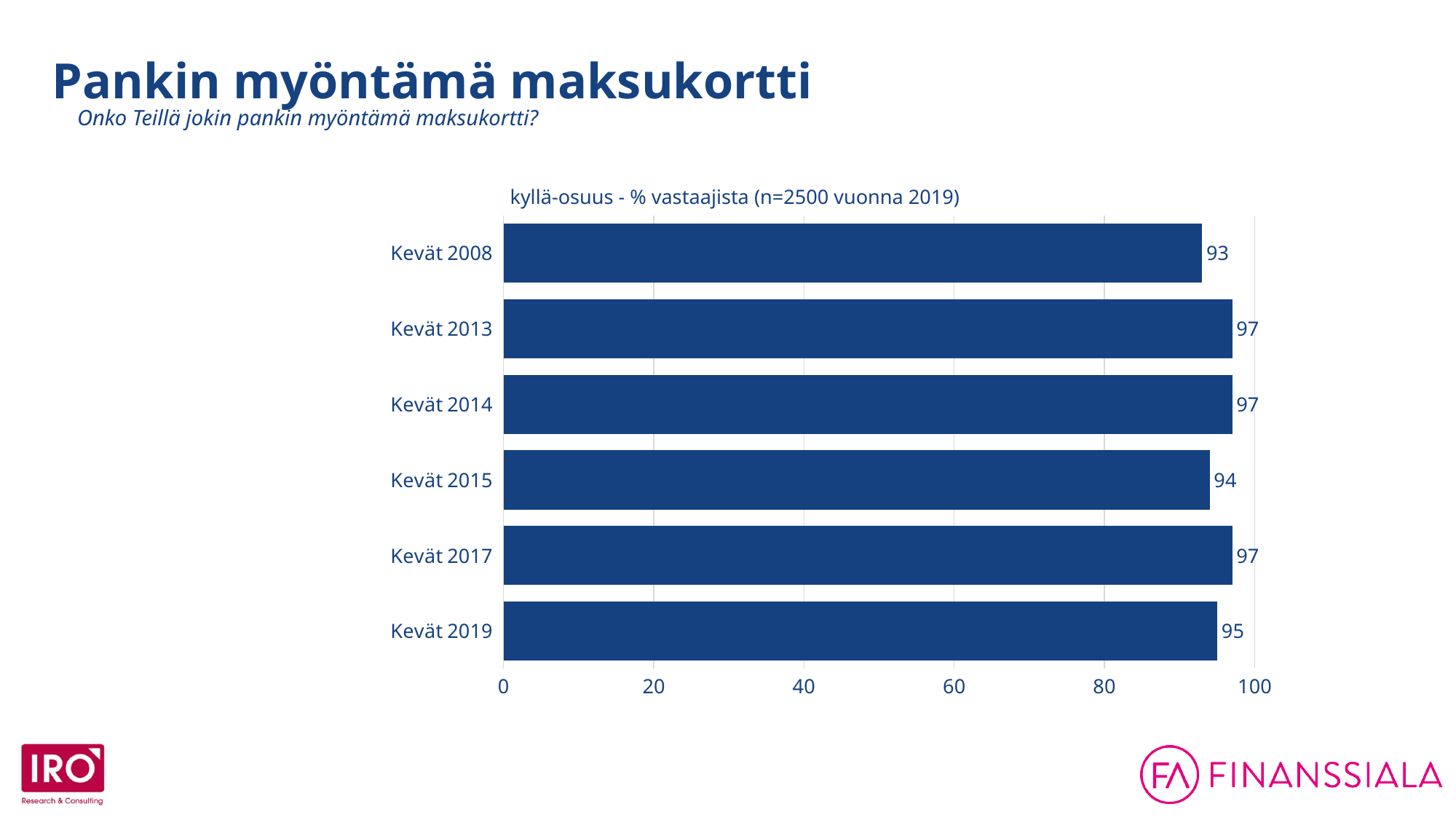
Which is larger, the value for Kevät 2014 or the value for Kevät 2015? Kevät 2014 What kind of chart is shown on the slide? bar chart What is the title of the chart? kyllä-osuus - % vastaajista (n=2500 vuonna 2019) Which category has the lowest value? Kevät 2008 What is the difference between the values for Kevät 2017 and Kevät 2019? 2 What is the value for Kevät 2008? 93 How many categories are shown in the chart? 6 Is the value for Kevät 2019 greater or less than 80? greater What is the value for Kevät 2013? 97 What is the value for Kevät 2015? 94 What is the value for Kevät 2019? 95 What is the difference between the values for Kevät 2015 and Kevät 2008? 1